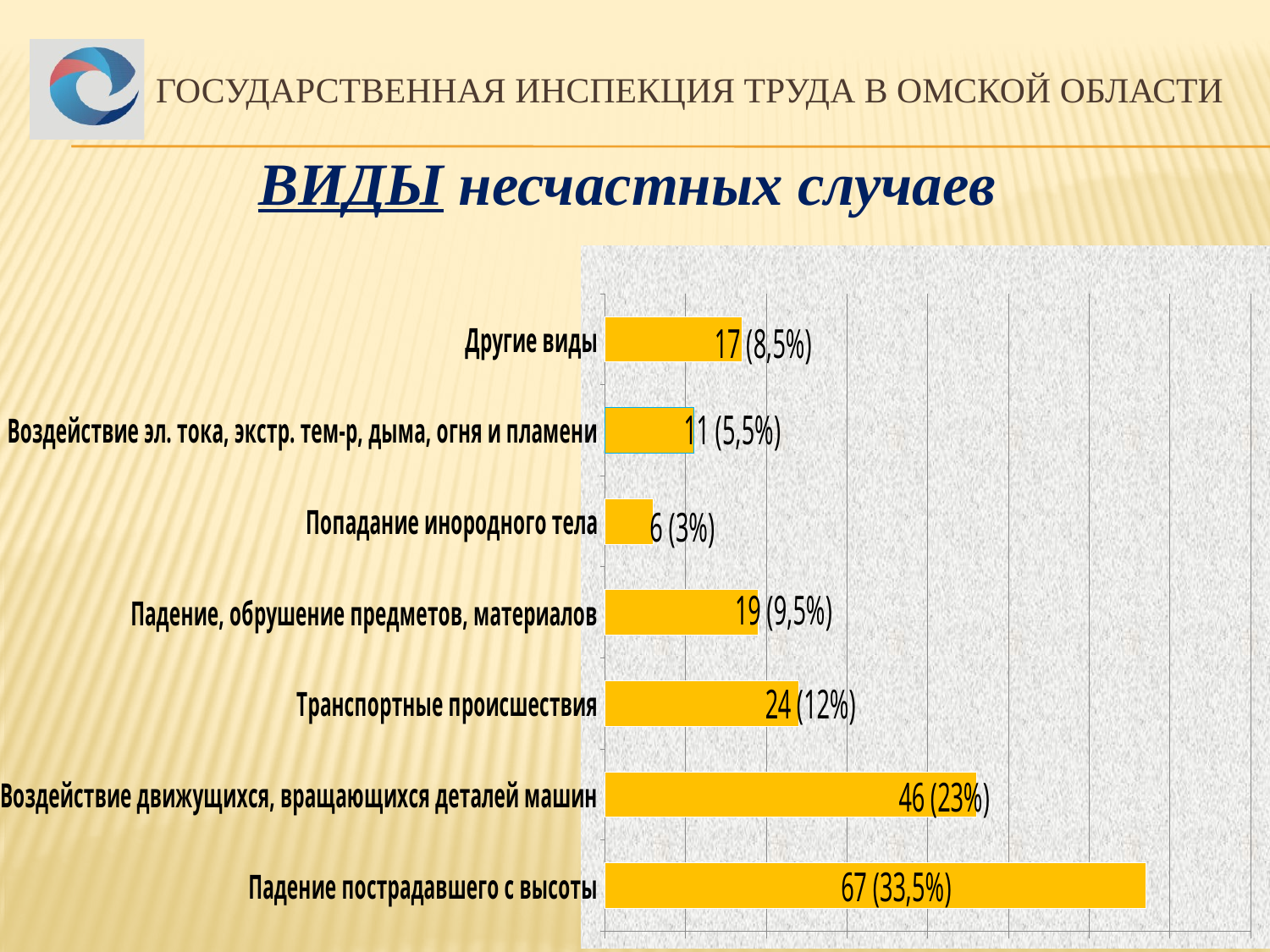
What is the title of the chart on the slide? ВИДЫ несчастных случаев What is the difference in count between "Транспортные происшествия" and "Падение, обрушение предметов, материалов"? 5 Which is larger: "Другие виды" or "Воздействие эл. тока, экстр. тем-р, дыма, огня и пламени"? Другие виды What value is shown for "Другие виды"? 17 (8,5%) What is the difference in count between "Падение пострадавшего с высоты" and "Воздействие движущихся, вращающихся деталей машин"? 21 What value is shown for "Транспортные происшествия"? 24 (12%) What value is shown for "Падение пострадавшего с высоты"? 67 (33,5%) Which category has the highest value? Падение пострадавшего с высоты How many categories are shown in the chart? 7 Which category has the lowest value? Попадание инородного тела What value is shown for "Попадание инородного тела"? 6 (3%) What kind of chart is shown on the slide? Bar chart